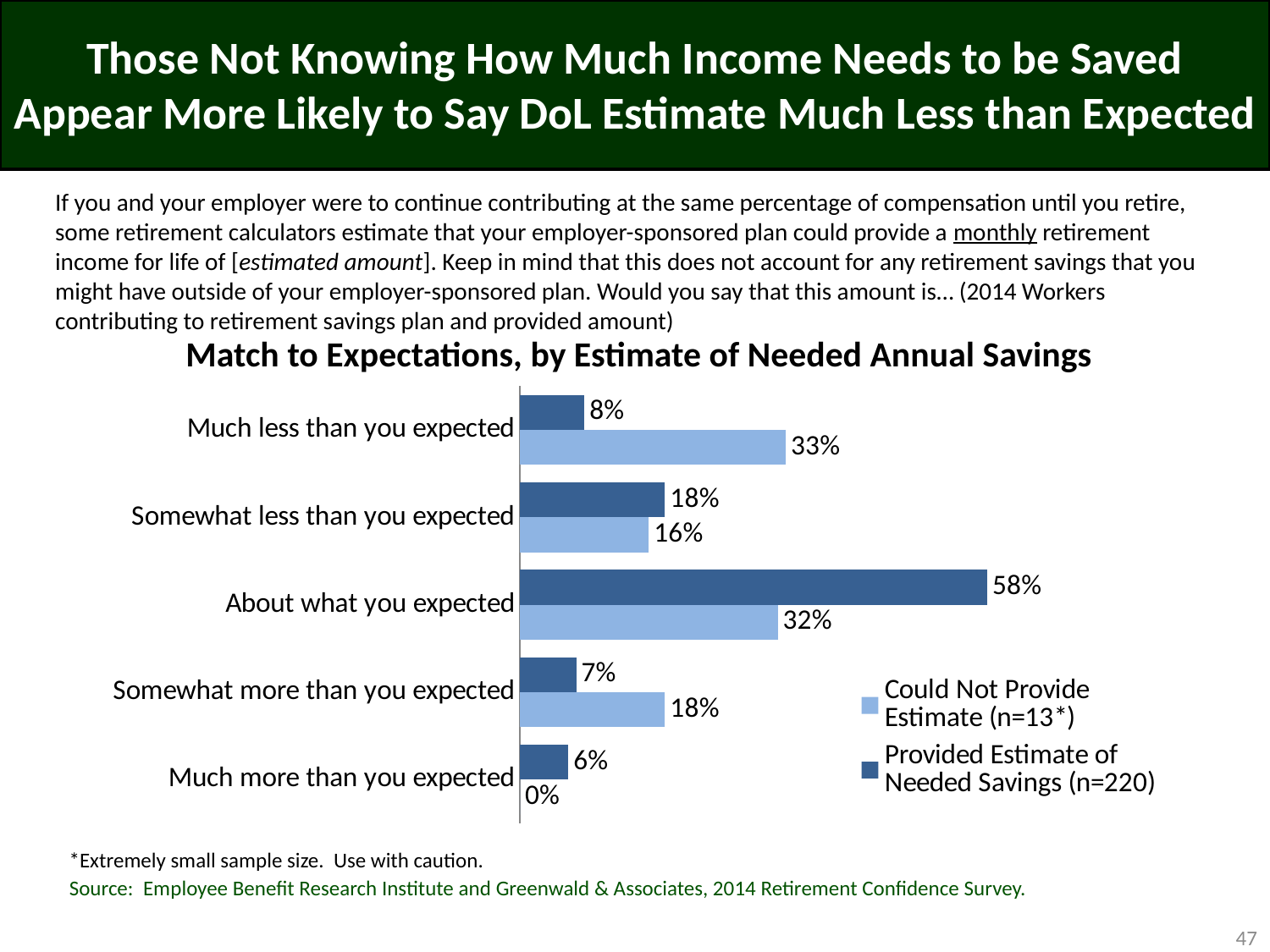
What is the value for "About what you expected" among those who Provided Estimate of Needed Savings? 58% Which category has the highest value for the Provided Estimate of Needed Savings series? About what you expected How many response categories are shown on the chart? 5 How many series does the legend list? 2 What is the title of the chart? Match to Expectations, by Estimate of Needed Annual Savings What is the value for "Much more than you expected" among those who Could Not Provide Estimate? 0% For "Much less than you expected", which series has the larger value? Could Not Provide Estimate What kind of chart is shown on the slide? Bar chart What is the value for "Much less than you expected" among those who Could Not Provide Estimate? 33% Which category has the lowest value for the Could Not Provide Estimate series? Much more than you expected What is the value for "Somewhat more than you expected" among those who Provided Estimate of Needed Savings? 7% What is the difference between the two series for "About what you expected"? 26 percentage points